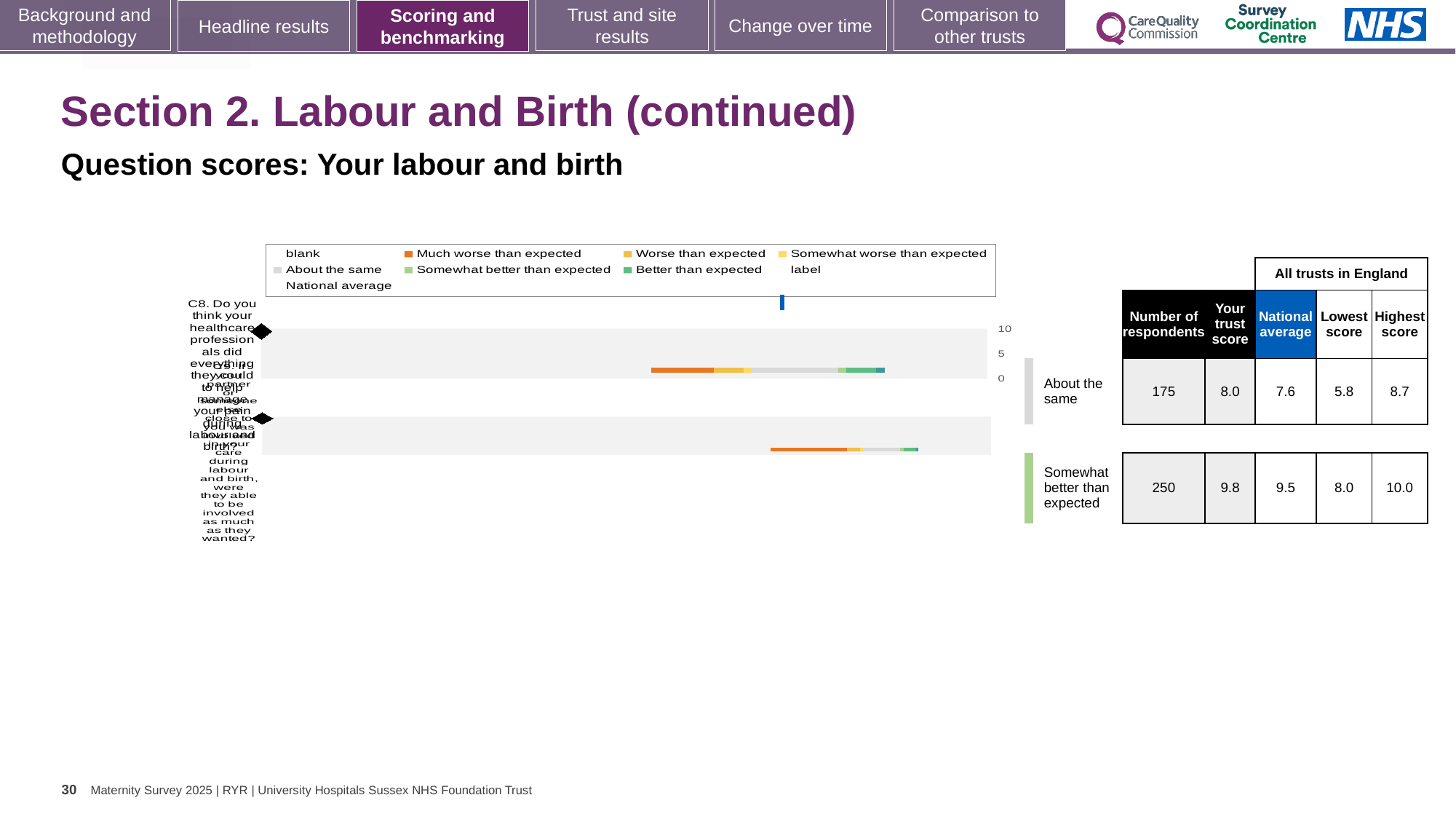
How many horizontal bars are plotted in the chart? 2 In the table beside the chart, what is the number of respondents for the row rated 'Somewhat better than expected'? 250 In the table beside the chart, what is the difference in number of respondents between the 'Somewhat better than expected' row and the 'About the same' row? 75 What colour represents 'Much worse than expected' in the chart legend? orange In the table beside the chart, what is the highest score across all trusts in England for the 'Somewhat better than expected' row? 10.0 In the table beside the chart, what is the number of respondents for the row rated 'About the same'? 175 In the table beside the chart, what is the national average for the row rated 'Somewhat better than expected'? 9.5 What kind of chart is shown on the slide? bar chart In the table beside the chart, what is the trust score for the row rated 'About the same'? 8.0 In the table beside the chart, which row has the higher trust score: 'About the same' or 'Somewhat better than expected'? Somewhat better than expected What colour represents 'Better than expected' in the chart legend? green In the table beside the chart, what is the lowest score across all trusts in England for the 'About the same' row? 5.8